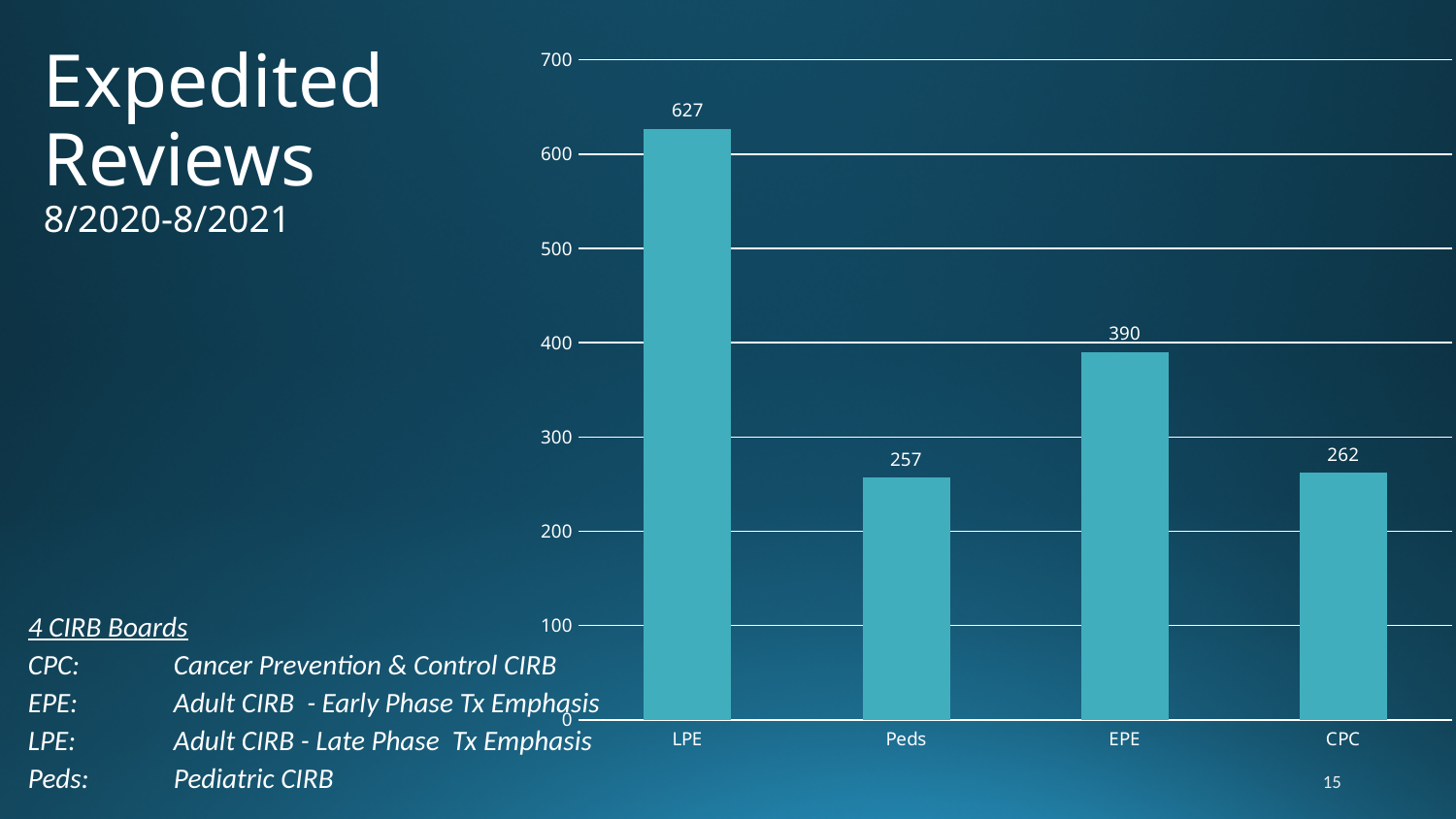
What is the value for EPE? 390 What is the value for LPE? 627 What is the value for CPC? 262 What kind of chart is shown on the slide? bar chart Which category has the lowest value? Peds Which category has the highest value? LPE What is the value for Peds? 257 How many categories are shown on the x axis? 4 What is the total of all four bars? 1536 What is the difference between the values for CPC and Peds? 5 Which is larger, the value for EPE or the value for CPC? EPE What is the difference between the values for LPE and EPE? 237